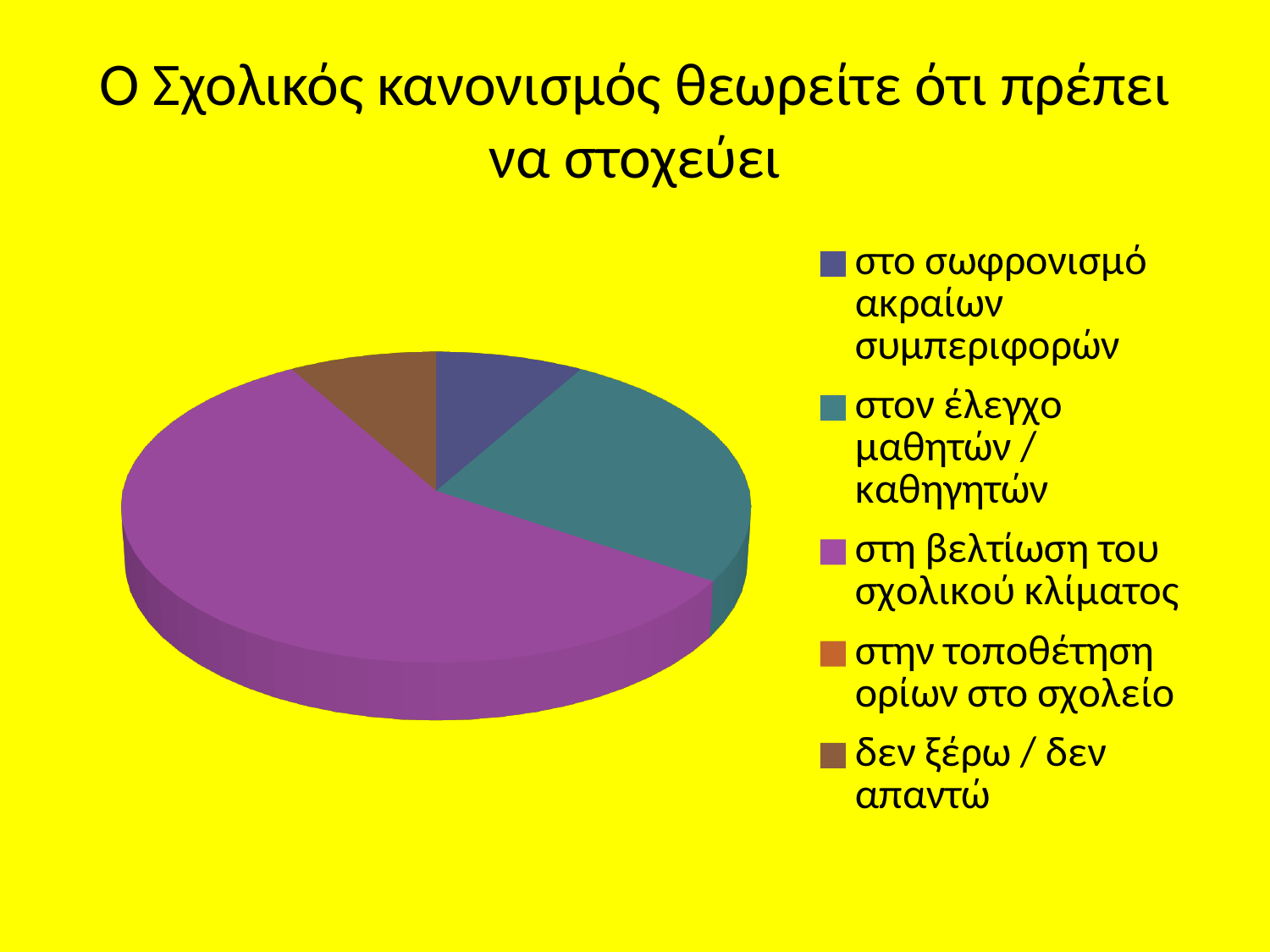
What kind of chart is shown on the slide? pie chart Which category has the largest slice of the pie? στη βελτίωση του σχολικού κλίματος Which slice is larger: "στη βελτίωση του σχολικού κλίματος" or "στον έλεγχο μαθητών / καθηγητών"? στη βελτίωση του σχολικού κλίματος What is the title of the chart slide? Ο Σχολικός κανονισμός θεωρείτε ότι πρέπει να στοχεύει How many entries does the legend list? 5 What colour is the slice for "στη βελτίωση του σχολικού κλίματος"? purple Which slice is larger: "στον έλεγχο μαθητών / καθηγητών" or "δεν ξέρω / δεν απαντώ"? στον έλεγχο μαθητών / καθηγητών Which slice is larger: "στον έλεγχο μαθητών / καθηγητών" or "στο σωφρονισμό ακραίων συμπεριφορών"? στον έλεγχο μαθητών / καθηγητών Does the slice for "στη βελτίωση του σχολικού κλίματος" cover more or less than half of the pie? more